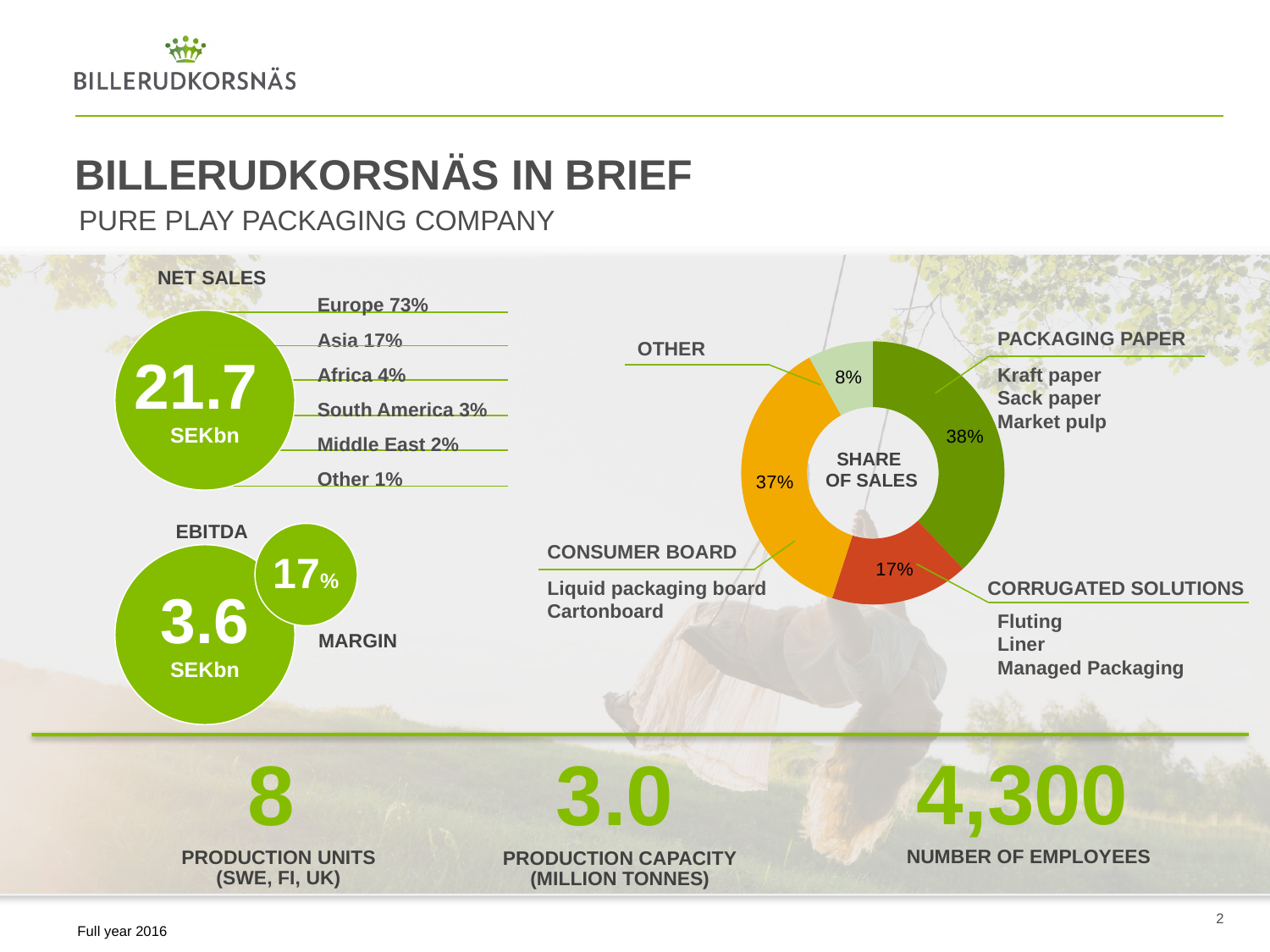
How many segments does the Share of Sales chart have? 4 Which segment has the largest share in the Share of Sales chart? Packaging Paper What share of sales does Corrugated Solutions account for in the Share of Sales chart? 17% What share of sales does Packaging Paper account for in the Share of Sales chart? 38% Which segment has the smallest share in the Share of Sales chart? Other In the Share of Sales chart, which is larger: Corrugated Solutions or Other? Corrugated Solutions What colour is the Consumer Board segment in the Share of Sales chart? Orange/yellow What share of sales does Consumer Board account for in the Share of Sales chart? 37% What kind of chart is the Share of Sales chart? Donut (pie) chart In the Share of Sales chart, what is the combined share of Packaging Paper and Consumer Board? 75% In the Share of Sales chart, what is the difference in percentage points between Packaging Paper and Corrugated Solutions? 21 percentage points What share of sales does the Other segment account for in the Share of Sales chart? 8%